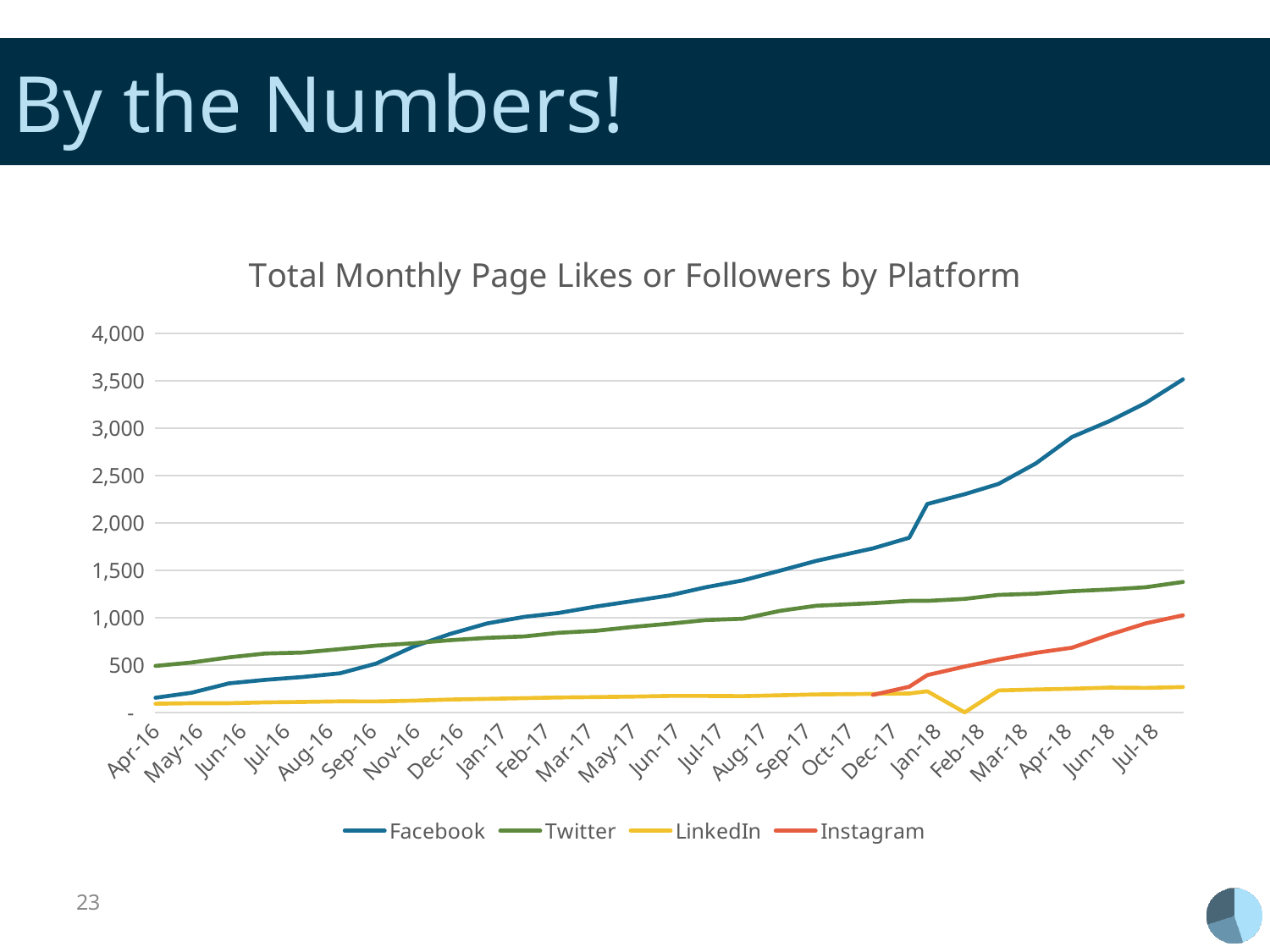
Which platform has the highest value at Jul-18? Facebook What is the title of the chart? Total Monthly Page Likes or Followers by Platform What kind of chart is shown on the slide? Line chart Is the value for Facebook at Apr-16 greater or less than 500? less Is the value for LinkedIn at Jul-18 greater or less than 500? less Do the Facebook values rise or fall from Apr-16 to Jul-18? Rise Which is larger at Apr-16, the value for Facebook or the value for Twitter? Twitter Which platform's line is drawn in red? Instagram Is the value for Facebook at Jul-18 greater or less than 3,000? greater How many series does the legend list? 4 Which platform has the lowest value at Jul-18? LinkedIn